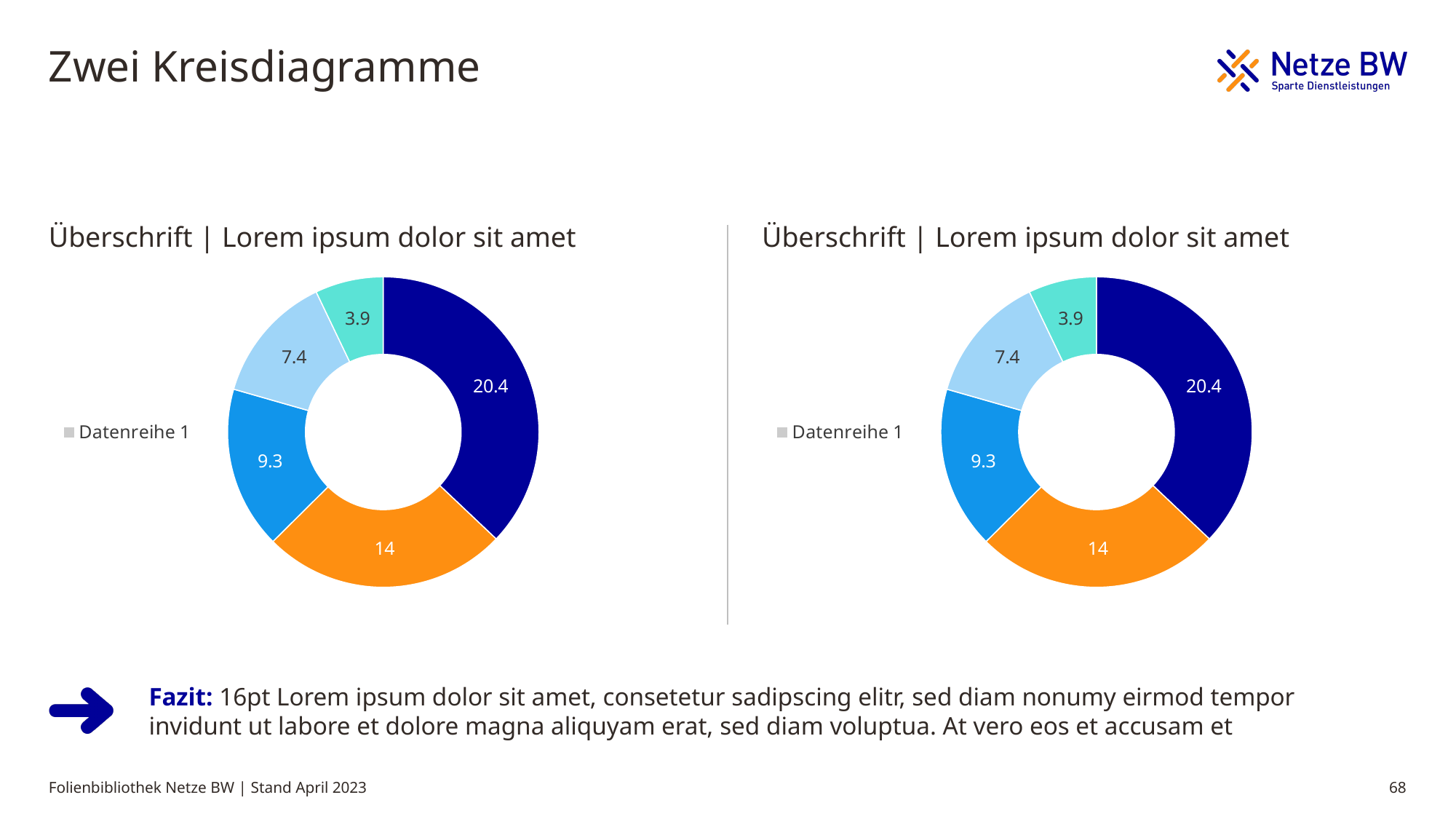
In the left chart, what is the difference between the dark blue slice (20.4) and the orange slice (14)? 6.4 How many slices does the left chart have? 5 In the left chart, what is the value of the dark blue slice? 20.4 In the right chart, which is larger: the blue slice (9.3) or the light blue slice (7.4)? The blue slice (9.3) In the right chart, which slice has the largest value? The dark blue slice (20.4) What is the total of all slice values in the right chart? 55 In the right chart, what is the value of the orange slice? 14 How many series does the legend of the right chart list? 1 What kind of chart is shown on the left side of the slide? Doughnut (pie) chart In the left chart, which slice has the smallest value? The teal slice (3.9) In the left chart, what is the value of the teal (smallest) slice? 3.9 What is the legend entry shown next to the left chart? Datenreihe 1